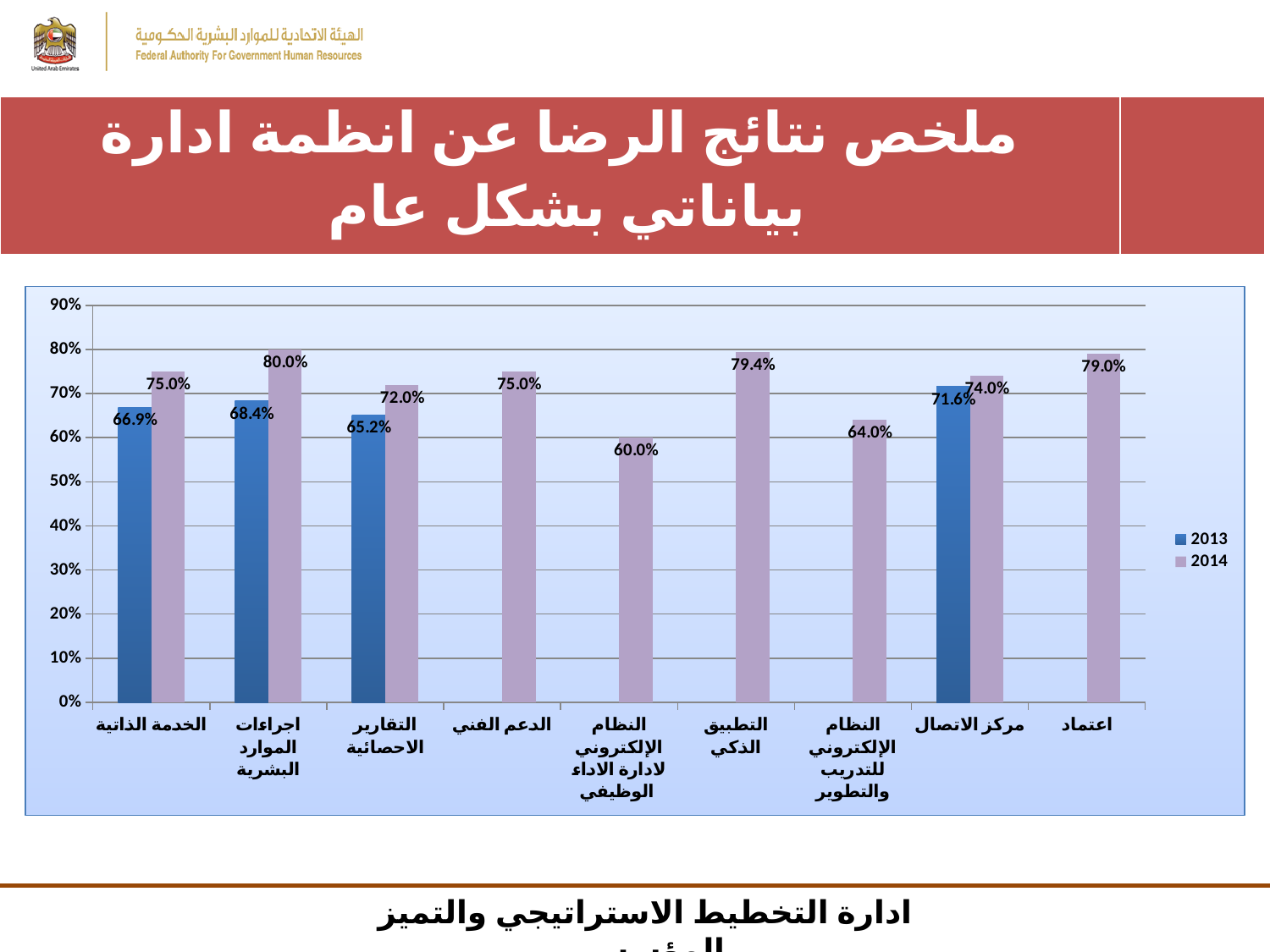
Which category has the lowest 2014 value? النظام الإلكتروني لادارة الاداء الوظيفي Which category has the highest 2014 value? اجراءات الموارد البشرية What is the difference between the 2014 and 2013 values for التقارير الاحصائية? 6.8% What kind of chart is shown on the slide? bar chart What is the 2014 value for اجراءات الموارد البشرية? 80.0% Which is larger, the 2014 value for التطبيق الذكي or the 2014 value for اعتماد? التطبيق الذكي What is the 2014 value for النظام الإلكتروني لادارة الاداء الوظيفي? 60.0% Is the 2014 value for النظام الإلكتروني للتدريب والتطوير greater or less than 70%? less What is the 2013 value for الخدمة الذاتية? 66.9% How many series does the legend list? 2 How many categories are shown on the x axis? 9 What is the 2013 value for مركز الاتصال? 71.6%